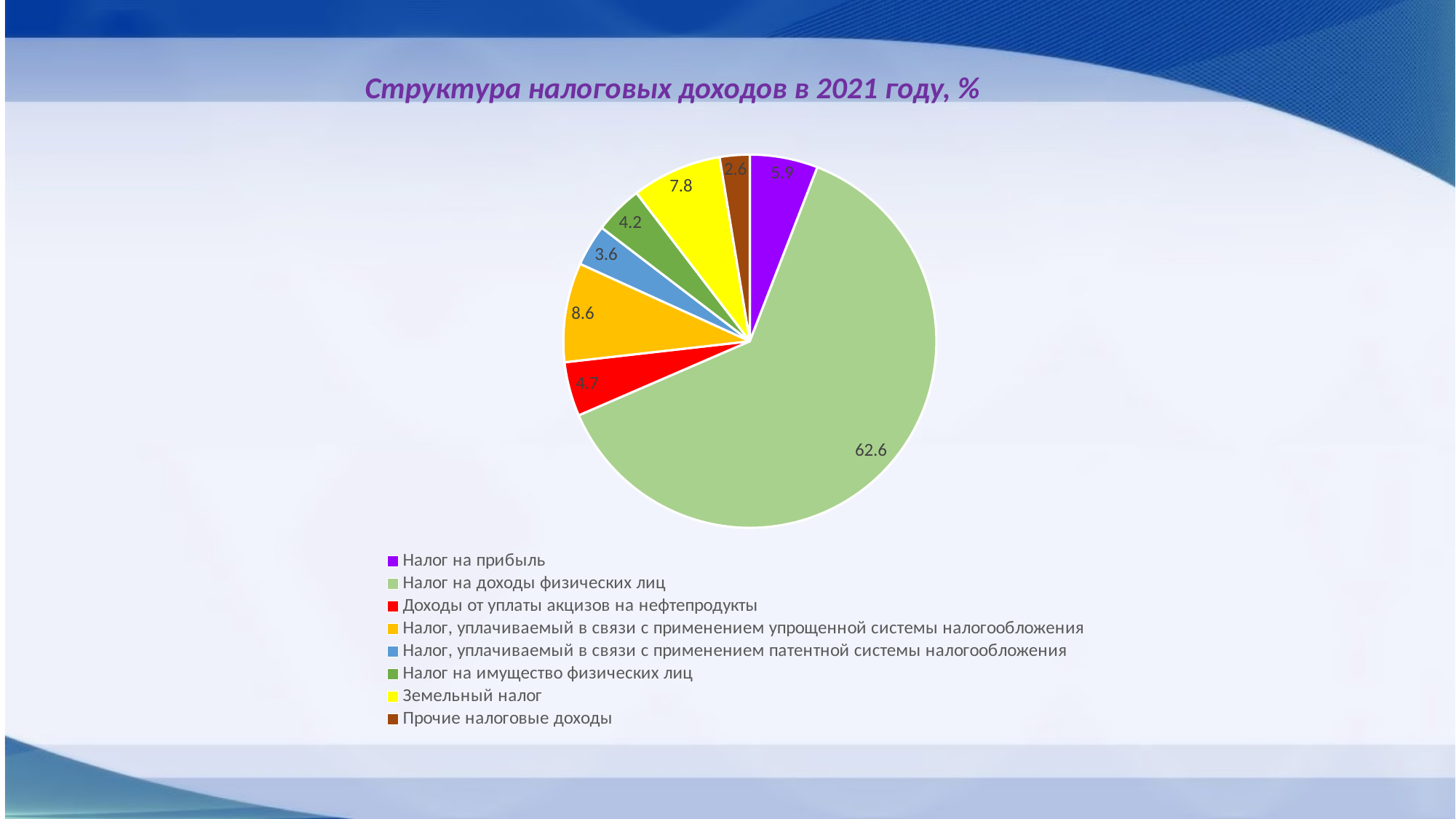
What is the value for Налог на доходы физических лиц? 62.6 What is the difference between the values for Налог, уплачиваемый в связи с применением упрощенной системы налогообложения and Доходы от уплаты акцизов на нефтепродукты? 3.9 How many slices does the pie chart have? 8 What is the value for Налог, уплачиваемый в связи с применением патентной системы налогообложения? 3.6 Which category has the smallest share of the pie? Прочие налоговые доходы What colour is the slice for Доходы от уплаты акцизов на нефтепродукты? Red What is the value for Налог на прибыль? 5.9 What is the title of the chart? Структура налоговых доходов в 2021 году, % Which is larger: Земельный налог or Налог на имущество физических лиц? Земельный налог What is the value for Земельный налог? 7.8 What kind of chart is shown on the slide? Pie chart Which category has the largest share of the pie? Налог на доходы физических лиц